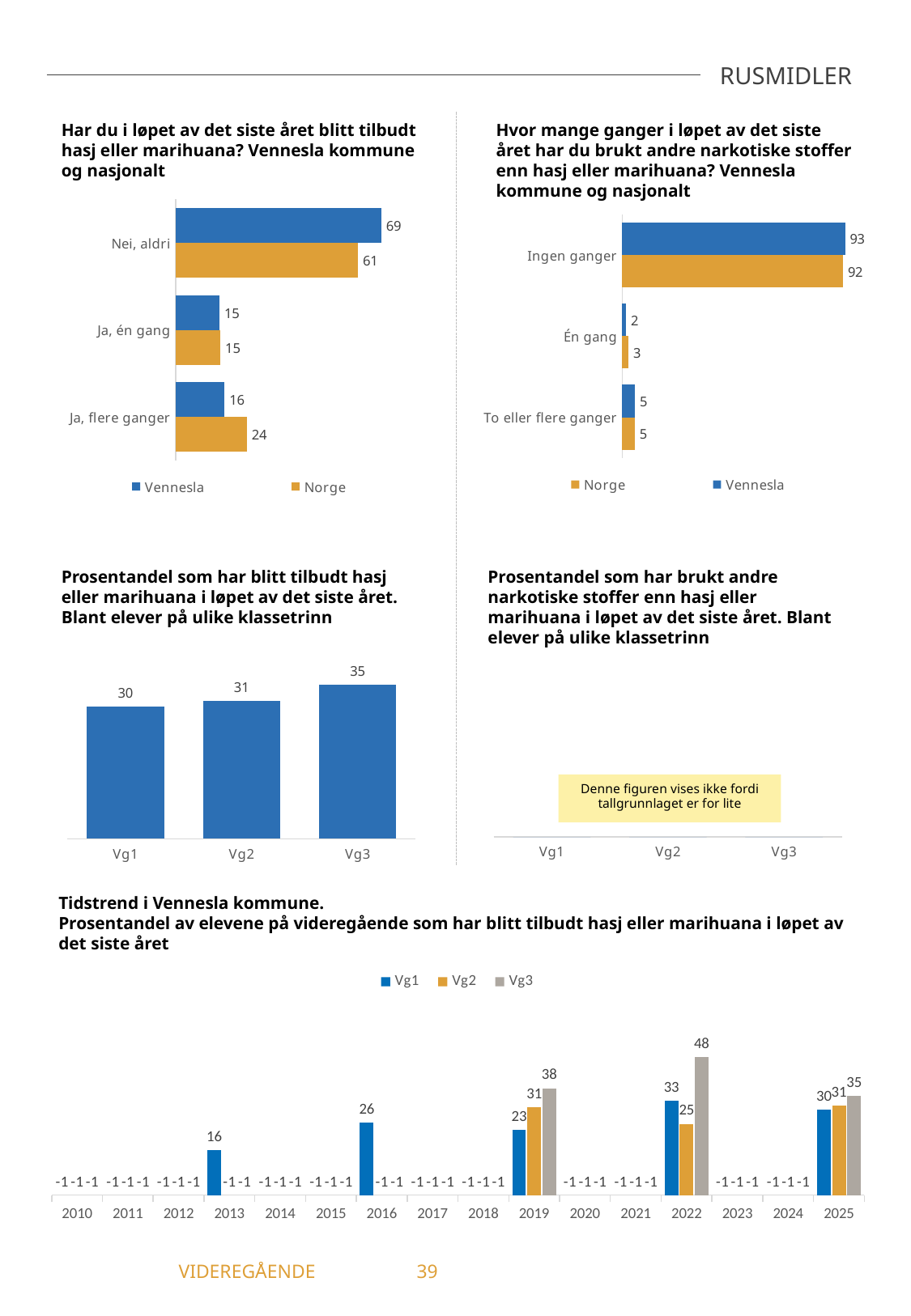
In the chart 'Har du i løpet av det siste året blitt tilbudt hasj eller marihuana?', which is larger for 'Nei, aldri': Vennesla or Norge? Vennesla In the chart 'Hvor mange ganger i løpet av det siste året har du brukt andre narkotiske stoffer enn hasj eller marihuana?', what is the value for Norge in the 'Ingen ganger' category? 92 What kind of chart is 'Prosentandel som har blitt tilbudt hasj eller marihuana i løpet av det siste året. Blant elever på ulike klassetrinn'? Bar chart In the 'Tidstrend i Vennesla kommune' chart, what is the value for Vg3 in 2022? 48 In the chart 'Har du i løpet av det siste året blitt tilbudt hasj eller marihuana?', what is the difference between Norge and Vennesla for 'Ja, flere ganger'? 8 In the chart 'Prosentandel som har blitt tilbudt hasj eller marihuana i løpet av det siste året. Blant elever på ulike klassetrinn', what is the value for Vg2? 31 In the 'Tidstrend i Vennesla kommune' chart, what is the value for Vg1 in 2016? 26 In the chart 'Prosentandel som har blitt tilbudt hasj eller marihuana i løpet av det siste året. Blant elever på ulike klassetrinn', which class level has the highest value? Vg3 In the chart 'Har du i løpet av det siste året blitt tilbudt hasj eller marihuana?', what is the value for Vennesla in the 'Nei, aldri' category? 69 How many series does the legend list in the chart 'Hvor mange ganger i løpet av det siste året har du brukt andre narkotiske stoffer enn hasj eller marihuana?'? 2 In the chart 'Hvor mange ganger i løpet av det siste året har du brukt andre narkotiske stoffer enn hasj eller marihuana?', what is the value for Vennesla in the 'Én gang' category? 2 In the 'Tidstrend i Vennesla kommune' chart, what is the difference between Vg3 and Vg1 in 2019? 15